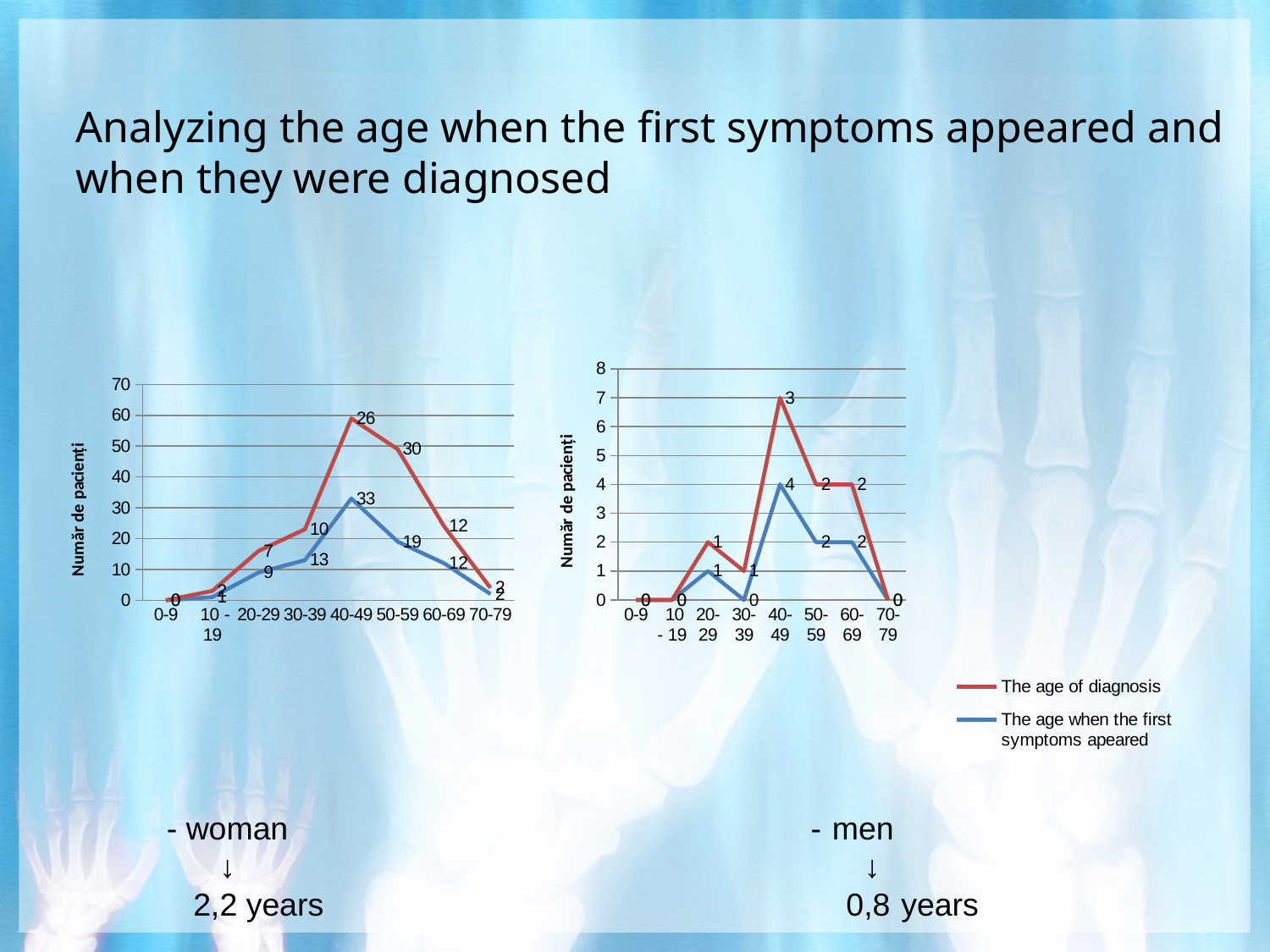
In the right chart (men), what is the value for the 40-49 age group on the 'The age when the first symptoms apeared' line? 4 In the left chart (woman), does the 'The age when the first symptoms apeared' line rise or fall from 40-49 to 70-79? fall What type of chart is the left chart (woman)? line chart In the left chart (woman), on the 'The age when the first symptoms apeared' line, which is larger: the 30-39 value or the 20-29 value? 30-39 In the left chart (woman), what is the value for the 50-59 age group on the 'The age when the first symptoms apeared' line? 19 Which colour represents 'The age of diagnosis' in the legend? red In the right chart (men), which age group has the highest value on the 'The age of diagnosis' line? 40-49 How many age groups are shown on the x axis of the right chart (men)? 8 In the left chart (woman), what is the difference between the 40-49 and 50-59 values on the 'The age when the first symptoms apeared' line? 14 How many series does the legend list? 2 In the left chart (woman), which age group has the highest value on the 'The age when the first symptoms apeared' line? 40-49 In the left chart (woman), what is the value for the 40-49 age group on the 'The age when the first symptoms apeared' line? 33